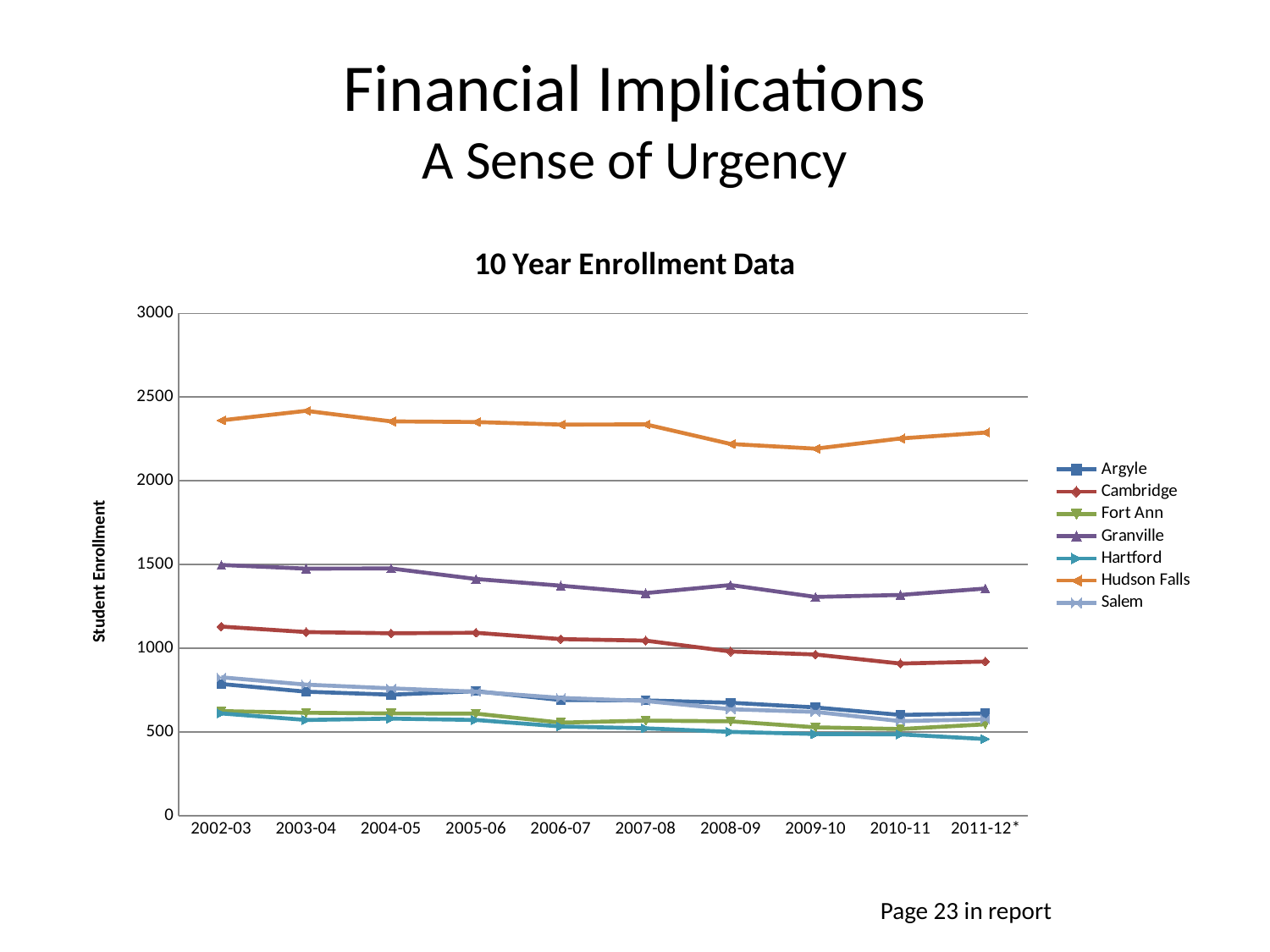
Is the value for Hartford in 2011-12* greater or less than 500? less In 2005-06, which has the larger enrollment, Granville or Cambridge? Granville How many school years are shown along the x axis? 10 Does the Cambridge enrollment rise or fall from 2002-03 to 2011-12*? fall Which district has the highest enrollment across the chart? Hudson Falls How many series does the legend list? 7 Which district has the lowest enrollment in 2011-12*? Hartford Is the value for Hudson Falls in 2002-03 greater or less than 2000? greater Is the value for Granville in 2011-12* greater or less than 1500? less What is the title of the chart? 10 Year Enrollment Data What kind of chart is shown on the slide? line chart